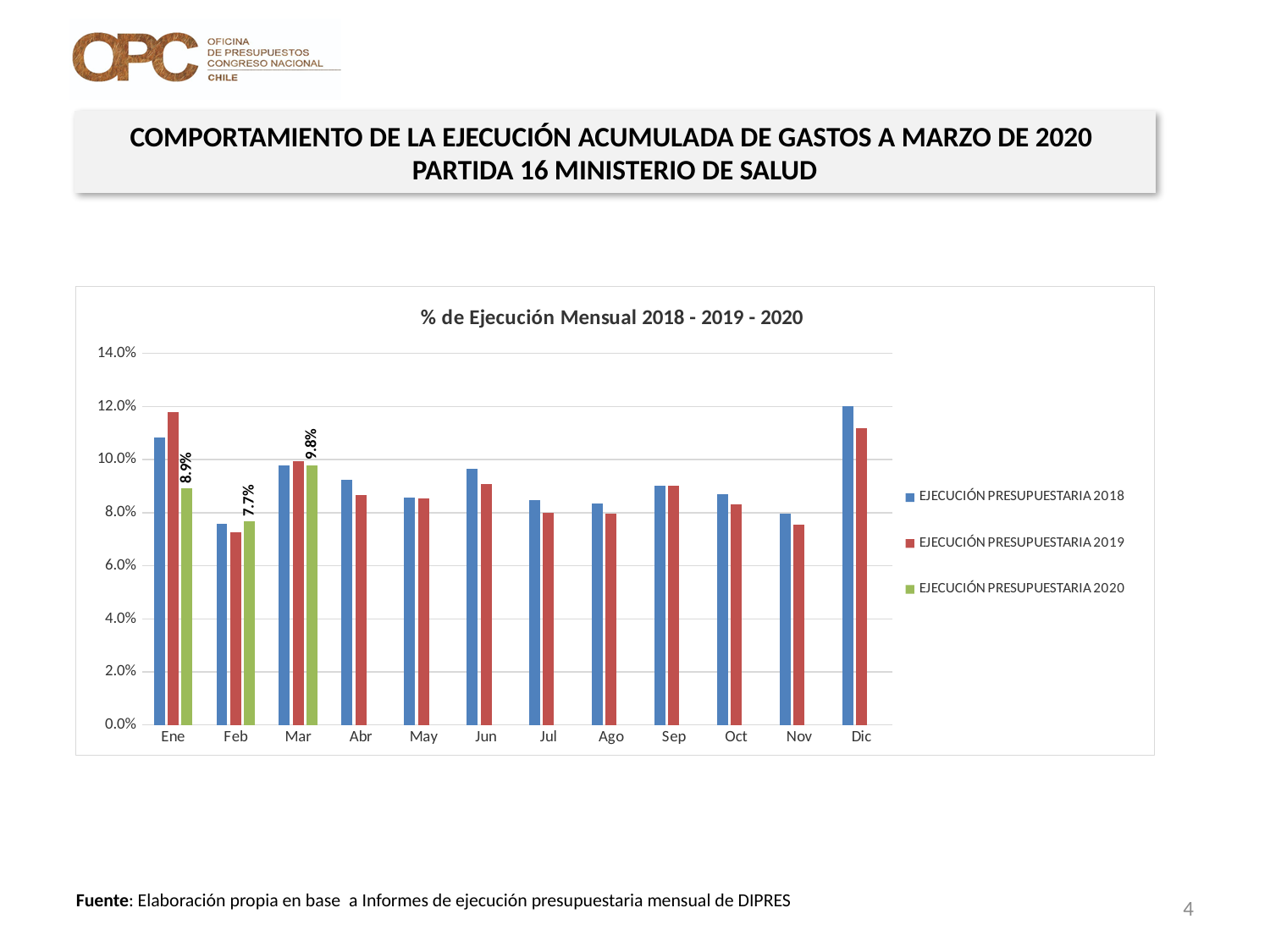
What is the value for EJECUCIÓN PRESUPUESTARIA 2020 in Mar? 9.8% Which month has the lowest value for EJECUCIÓN PRESUPUESTARIA 2020? Feb How many months are shown on the x axis of the chart? 12 Which month has the highest value for EJECUCIÓN PRESUPUESTARIA 2020? Mar What is the value for EJECUCIÓN PRESUPUESTARIA 2020 in Ene? 8.9% Is the value for EJECUCIÓN PRESUPUESTARIA 2018 in Dic greater or less than 10.0%? greater In Ene, which is larger: EJECUCIÓN PRESUPUESTARIA 2018 or EJECUCIÓN PRESUPUESTARIA 2019? EJECUCIÓN PRESUPUESTARIA 2019 What is the difference between the EJECUCIÓN PRESUPUESTARIA 2020 values for Mar and Feb? 2.1 percentage points How many series does the legend list? 3 Is the value for EJECUCIÓN PRESUPUESTARIA 2019 in Feb greater or less than 8.0%? less What is the value for EJECUCIÓN PRESUPUESTARIA 2020 in Feb? 7.7% What kind of chart is shown on the slide? Bar chart